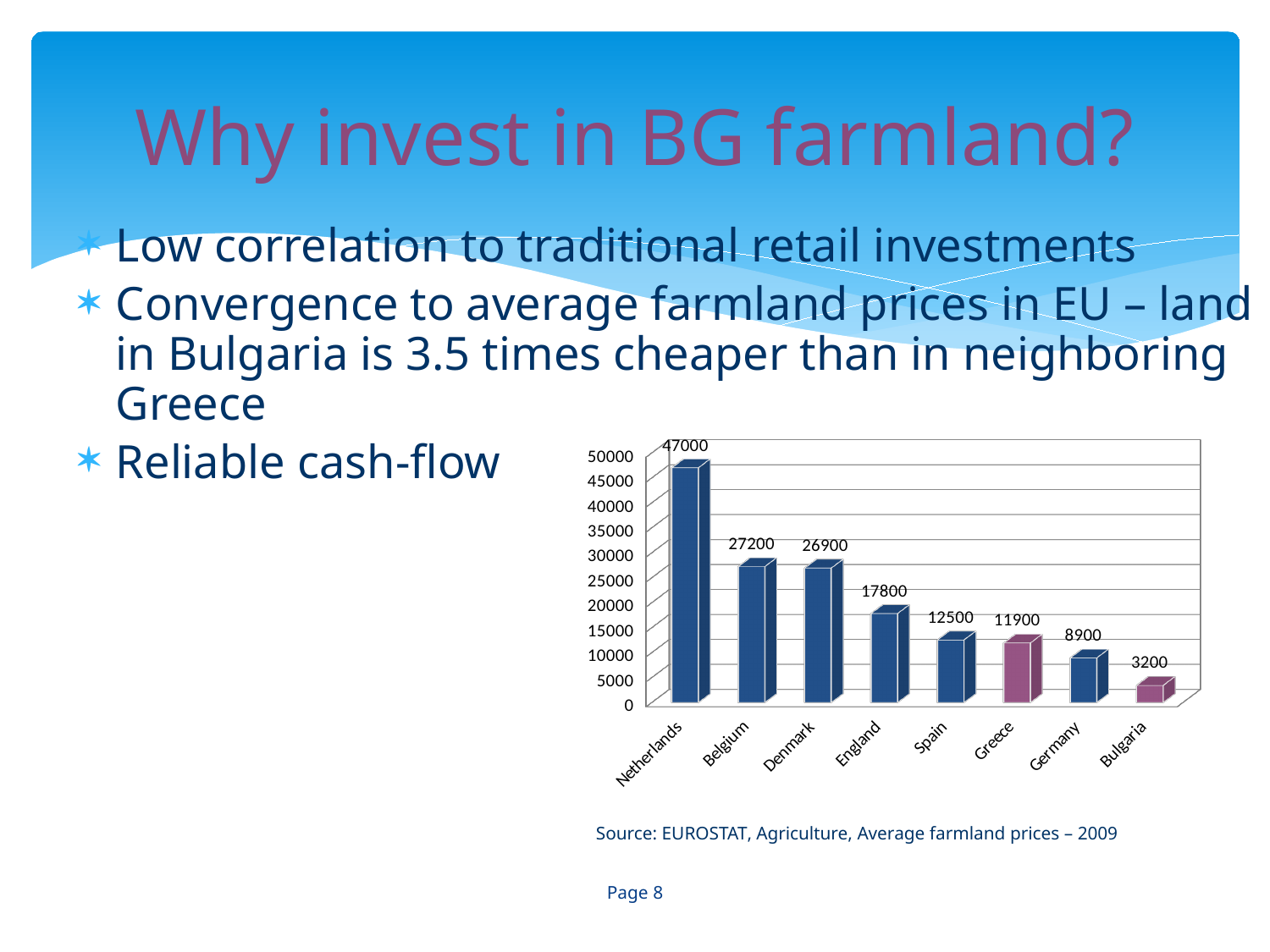
What is the value shown for Greece in the chart? 11900 Which country has the lowest value in the chart? Bulgaria Is the value for Germany greater or less than 10000? less What is the value shown for the Netherlands in the chart? 47000 Which has a larger value, England or Spain? England What is the value shown for Bulgaria in the chart? 3200 What is the difference between the values for Belgium and Denmark? 300 Which two bars in the chart are coloured differently (purple) from the rest? Greece and Bulgaria How many countries are shown in the chart? 8 What kind of chart is shown on the slide? bar chart Which country has the highest value in the chart? Netherlands What is the difference between the values for Greece and Bulgaria? 8700